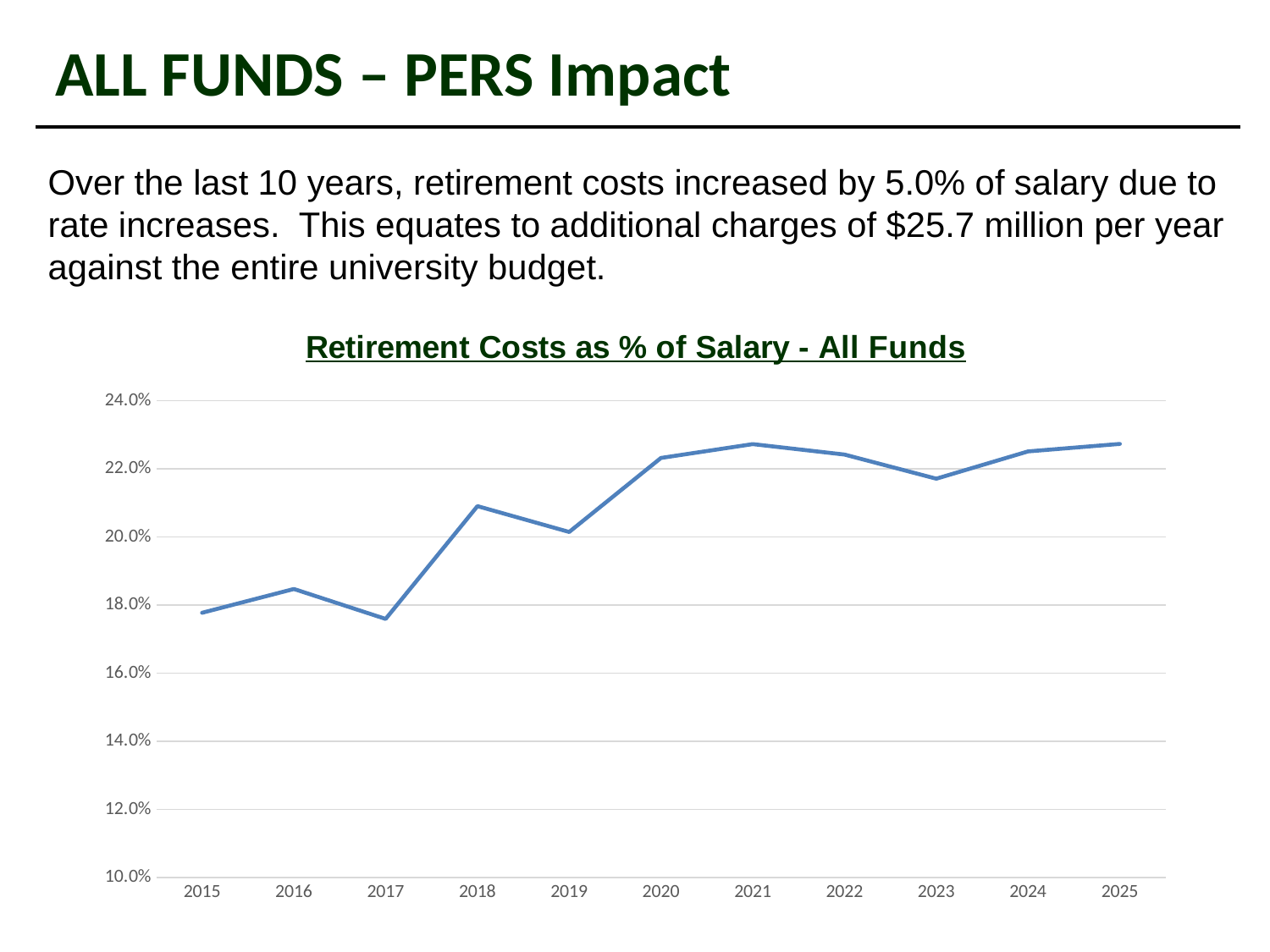
Which year has the higher value, 2017 or 2018? 2018 Is the value for 2018 greater or less than 20.0%? greater What is the lowest value shown on the y axis of the chart? 10.0% Is the value for 2023 greater or less than 22.0%? less What is the title of the chart? Retirement Costs as % of Salary - All Funds Overall, do retirement costs as a percentage of salary rise or fall from 2015 to 2025? rise Is the value for 2016 greater or less than 18.0%? greater What kind of chart is shown on the slide? line chart Which year has the higher value, 2022 or 2023? 2022 How many years are plotted on the x axis of the chart? 11